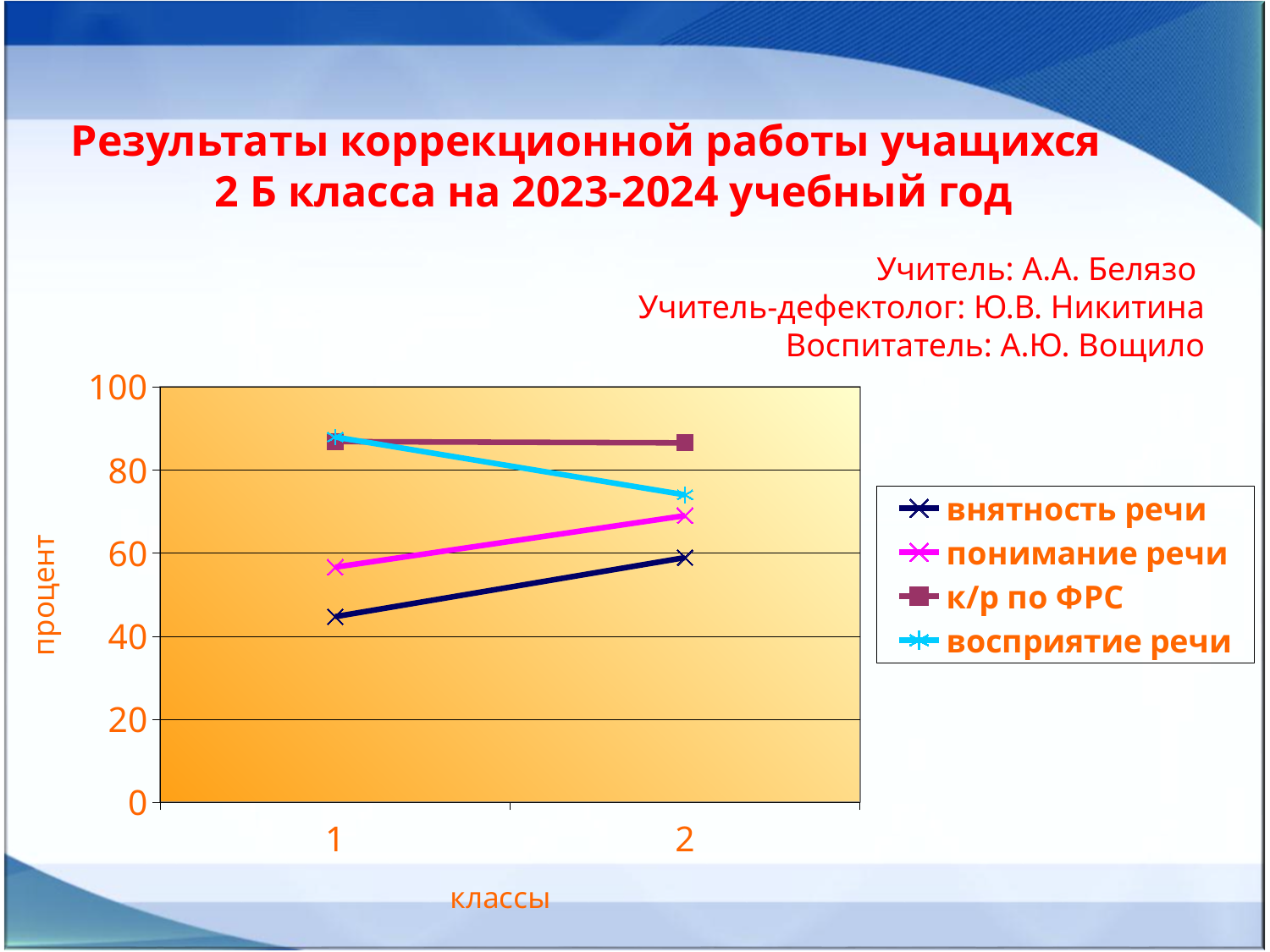
How many series does the legend list? 4 What is the label of the y axis? процент What kind of chart is shown on the slide? line chart Which series has the highest value at class 2? к/р по ФРС Is the value for понимание речи at class 2 greater or less than 60? greater How many categories are shown on the x axis? 2 Is the value for внятность речи at class 1 greater or less than 60? less Does the value for восприятие речи rise or fall from class 1 to class 2? fall Does the value for внятность речи rise or fall from class 1 to class 2? rise Does the value for понимание речи rise or fall from class 1 to class 2? rise Which series has the lowest value at class 1? внятность речи Is the value for восприятие речи at class 1 greater or less than 80? greater